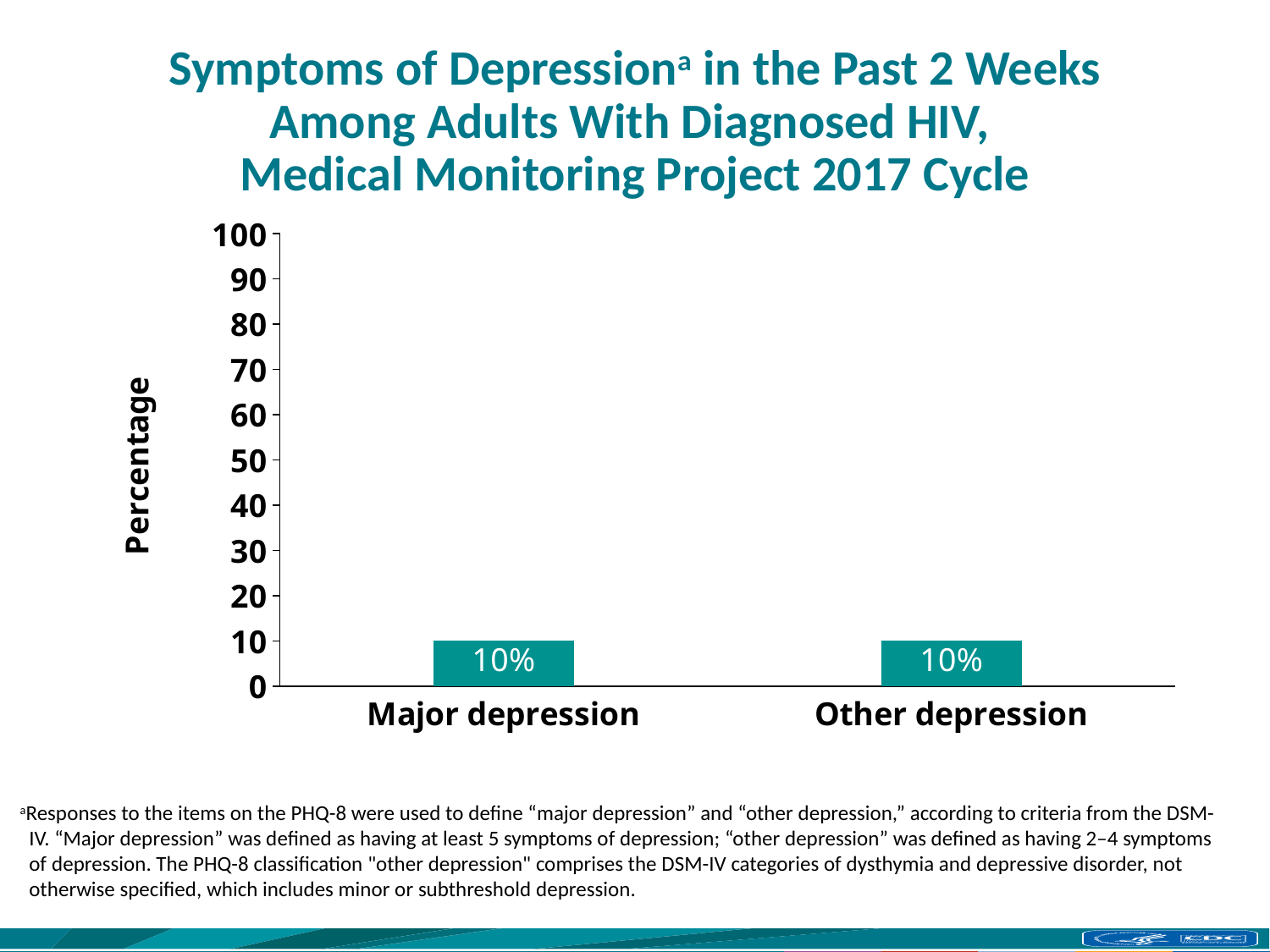
What is the label of the y axis? Percentage How many categories are shown on the x axis? 2 What is the highest value shown on the y axis? 100 What is the difference between the values for Major depression and Other depression? 0% What is the total of the two bar values shown? 20% Is the value for Major depression greater or less than 50? less What kind of chart is shown on the slide? bar chart What is the value for Other depression? 10% What is the value for Major depression? 10% Is the value for Other depression greater or less than 20? less